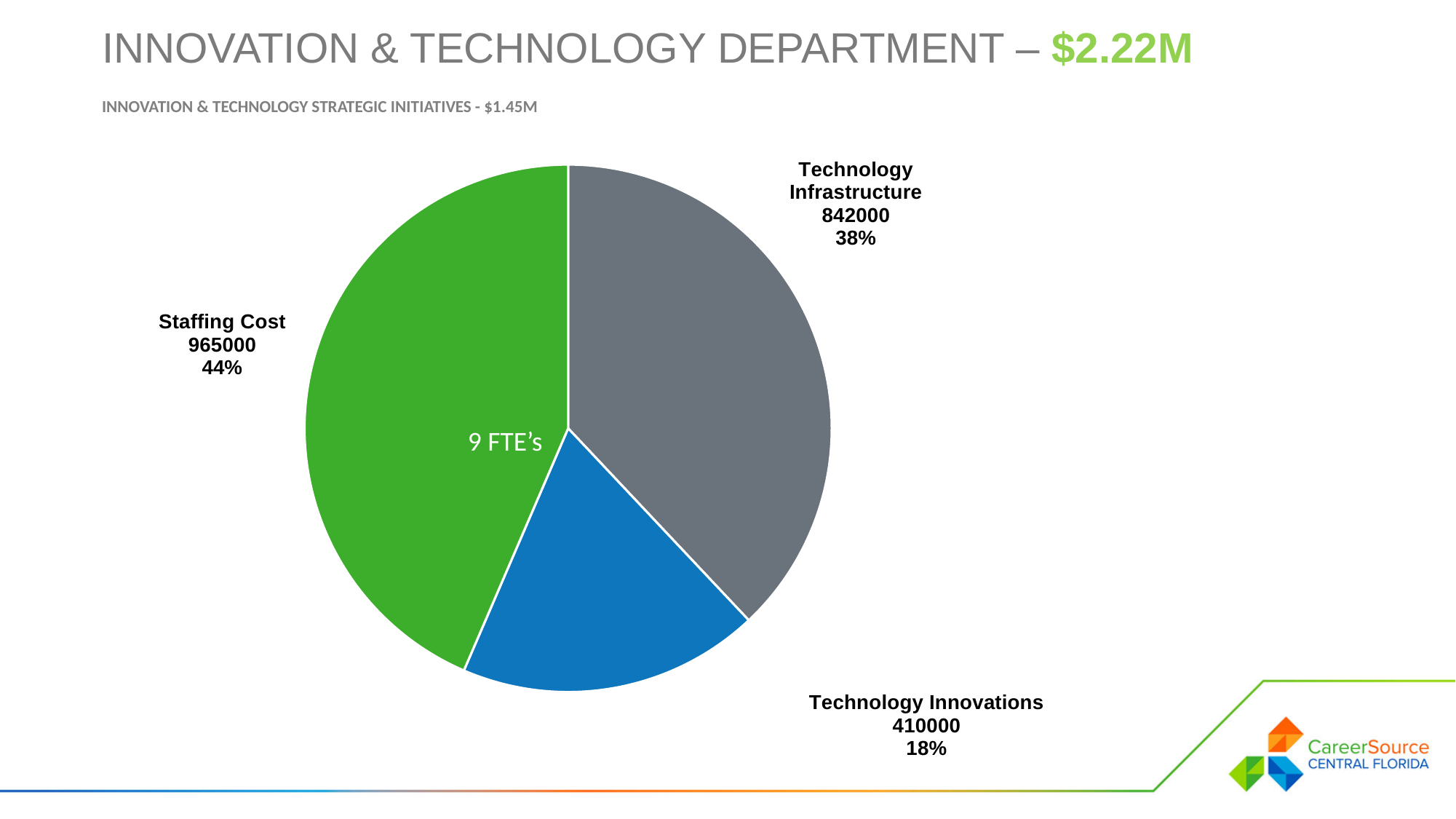
What kind of chart is shown on the slide? Pie chart What share of the pie does Technology Innovations represent? 18% How many slices does the pie chart have? 3 What is the difference between the Staffing Cost value and the Technology Infrastructure value? 123000 Which is larger, Technology Infrastructure or Technology Innovations? Technology Infrastructure What is the value for Technology Infrastructure? 842000 Which category has the smallest slice of the pie? Technology Innovations What is the value for Technology Innovations? 410000 What text is printed inside the Staffing Cost slice? 9 FTE’s Which category has the largest slice of the pie? Staffing Cost What is the difference between the Technology Infrastructure value and the Technology Innovations value? 432000 What is the value for Staffing Cost? 965000